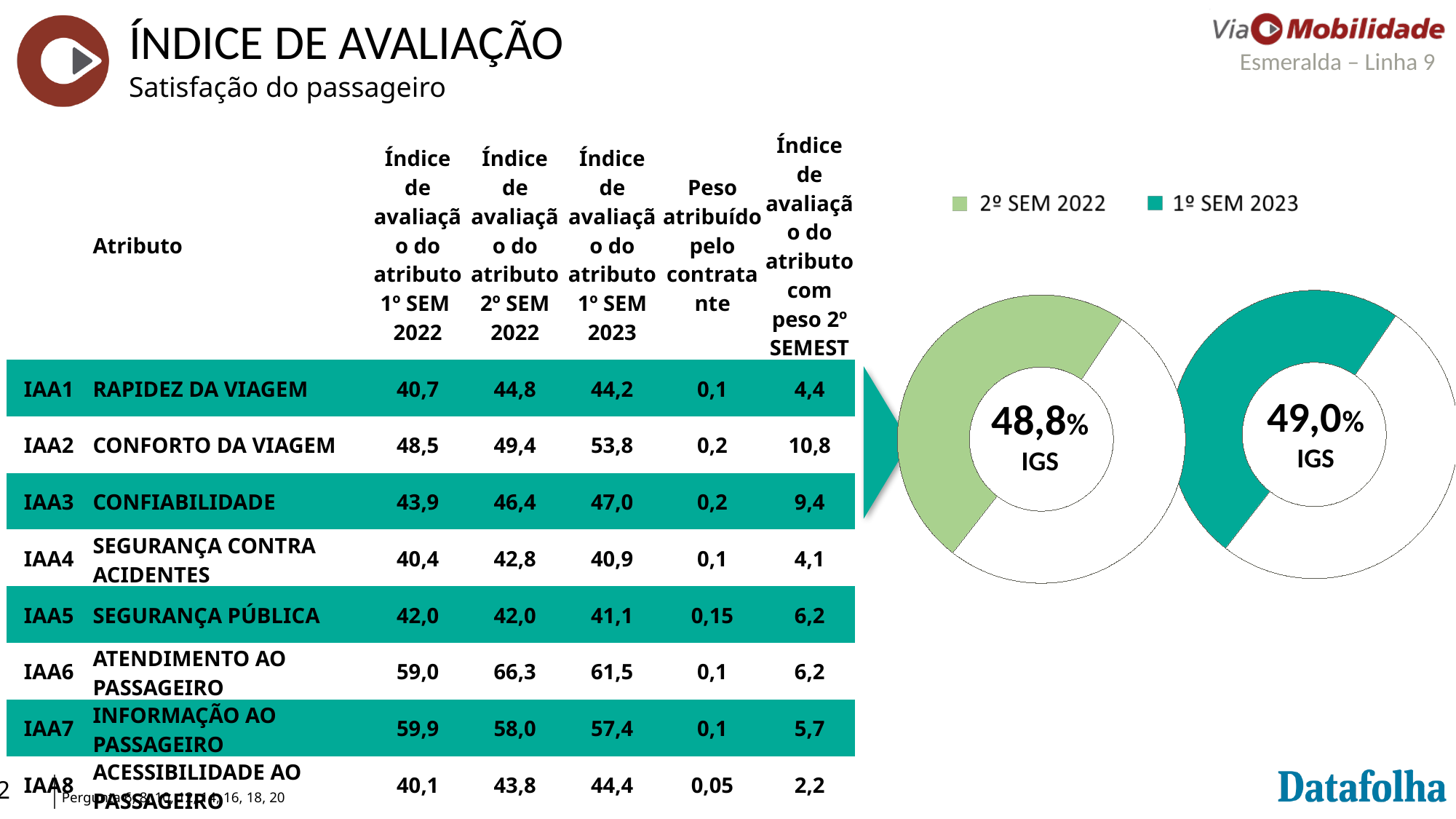
What value is shown in the centre of the donut chart for 1º SEM 2023? 49,0% Which semester's donut chart shows the higher IGS value, 2º SEM 2022 or 1º SEM 2023? 1º SEM 2023 What is the difference between the IGS value for 1º SEM 2023 and the IGS value for 2º SEM 2022? 0,2 Did the IGS value rise or fall from 2º SEM 2022 to 1º SEM 2023? Rise Is the IGS value for 1º SEM 2023 greater or less than 50%? less What value is shown in the centre of the donut chart for 2º SEM 2022? 48,8% Which legend entry is shown in light green? 2º SEM 2022 What kind of chart is used to display the IGS values on the right of the slide? Donut (pie) chart How many entries does the legend above the donut charts list? 2 What label appears below the percentage in the centre of each donut chart? IGS Which semester's donut chart shows the lower IGS value? 2º SEM 2022 How many donut charts are shown on the slide? 2